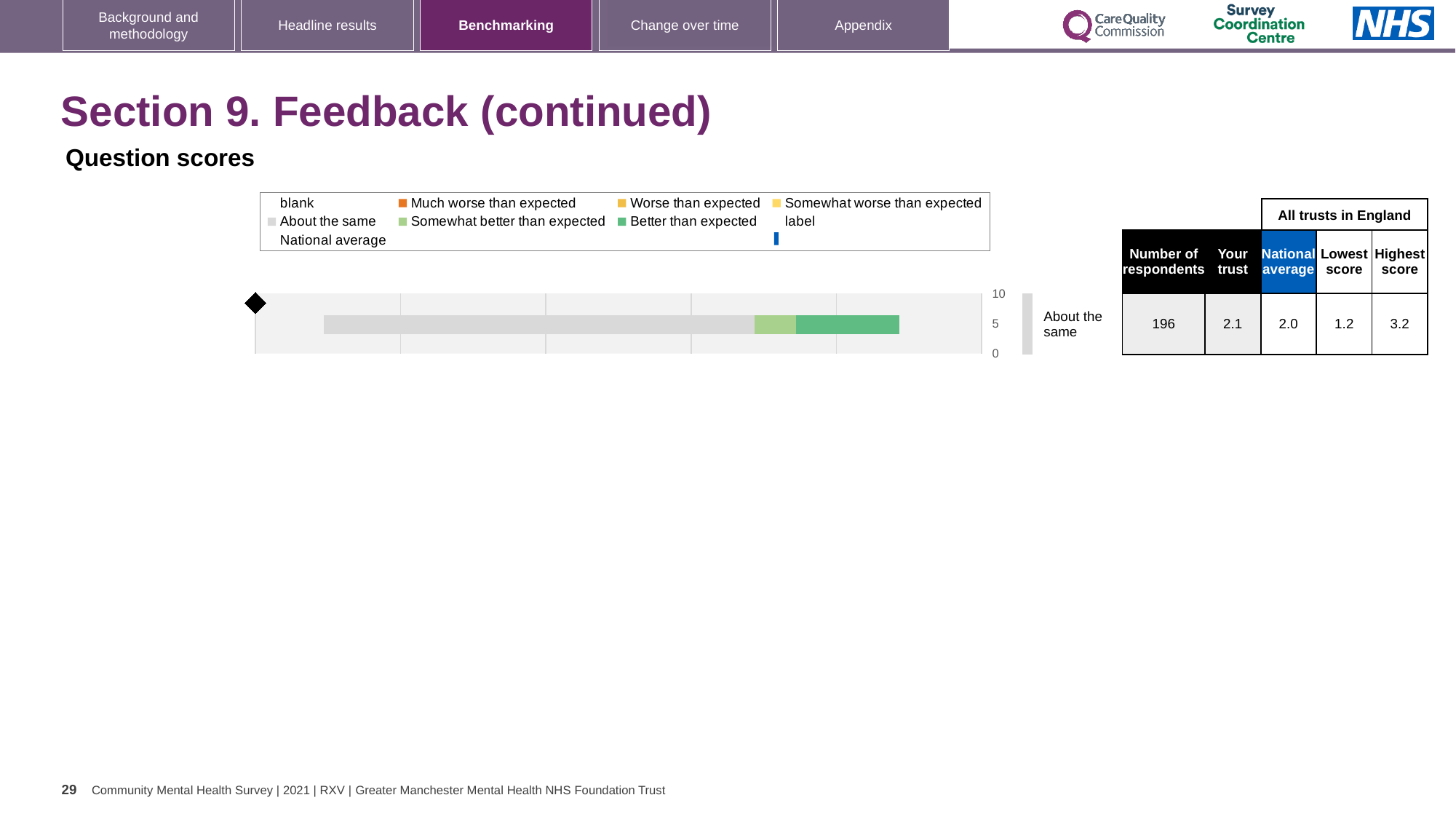
In the table beside the chart, how many respondents are listed for the 'About the same' question? 196 In the table beside the chart, what is the 'Your trust' score for the 'About the same' question? 2.1 How many entries does the chart legend list? 9 What kind of chart is shown on the slide? bar chart How many question bars are plotted in the chart? 1 What colour represents 'Better than expected' in the chart legend? green What category label is shown next to the plotted bar? About the same In the table beside the chart, which is larger: the 'Your trust' score or the National average? Your trust What colour represents 'About the same' in the chart legend? grey In the table beside the chart, what is the National average score for the 'About the same' question? 2.0 In the table beside the chart, what is the difference between the Highest score and the Lowest score? 2.0 In the table beside the chart, what is the Highest score among all trusts in England? 3.2